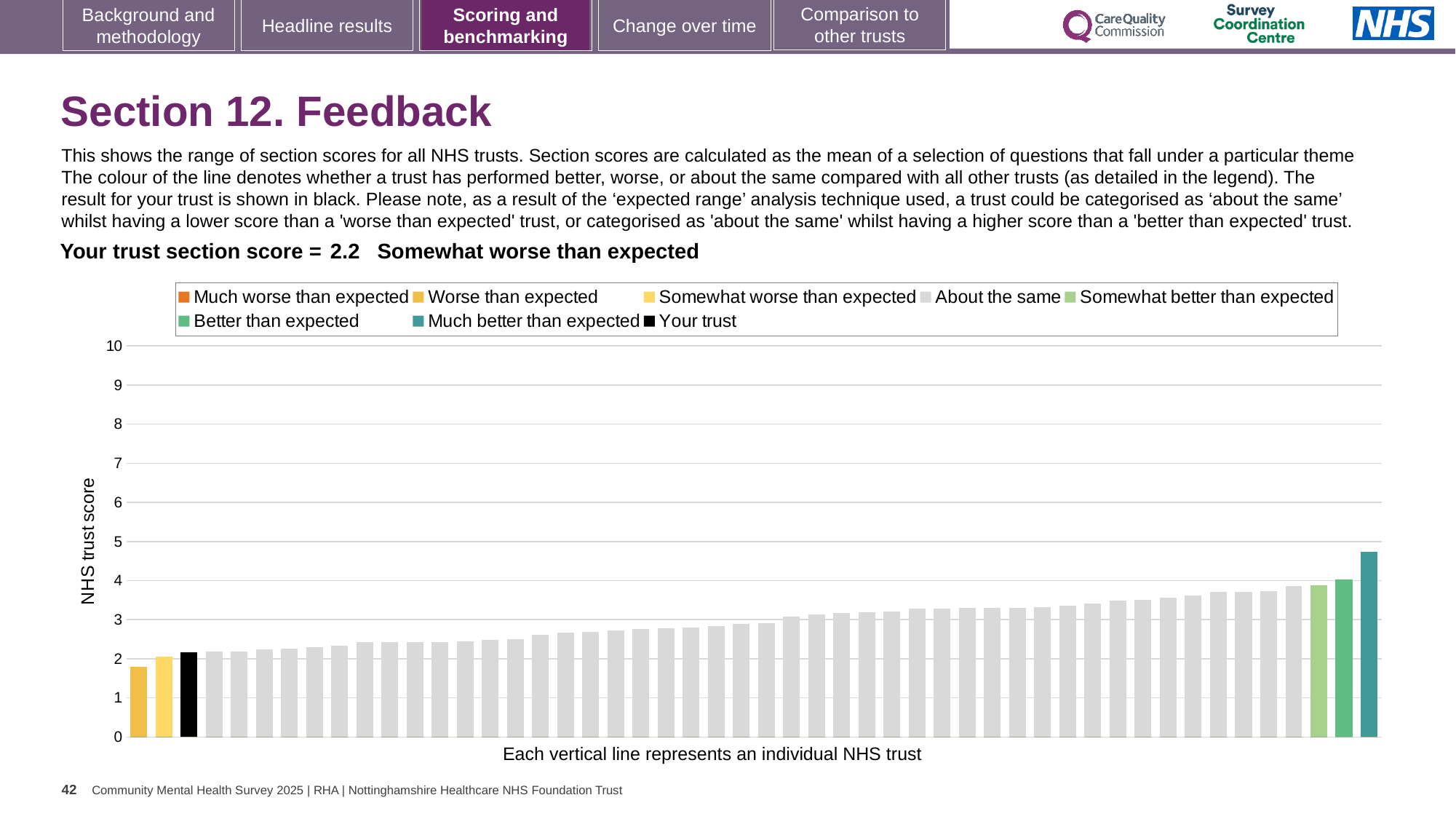
According to the slide, which category is your trust's section score placed in? Somewhat worse than expected Is the value of the tallest bar (the teal 'Much better than expected' trust) greater or less than 4? greater Which legend category does the shortest bar belong to? Worse than expected Which legend category does the tallest bar belong to? Much better than expected Which is taller: the black 'Your trust' bar or the leftmost bar? The black 'Your trust' bar What is the section score for your trust, as stated on the slide? 2.2 Do the bar values rise or fall from left to right along the x axis? rise Is the value of the leftmost bar greater or less than 2? less What is the label on the y axis of the chart? NHS trust score What kind of chart is shown on the slide? Bar chart How many entries does the chart legend list? 8 Is the value for your trust (the black bar) greater or less than 3? less